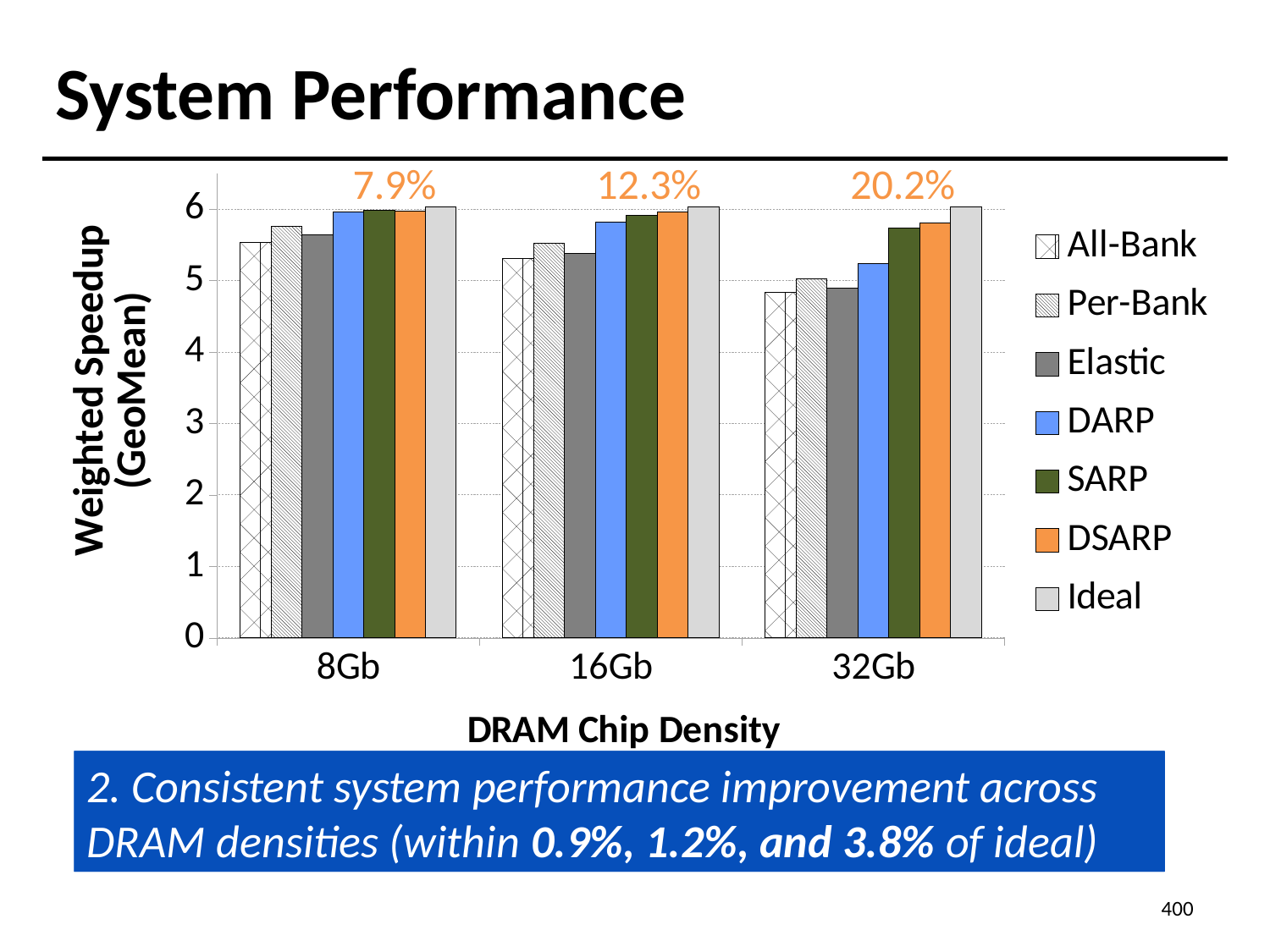
Is the value for DARP at 32Gb greater or less than 5? greater Does the All-Bank weighted speedup rise or fall as DRAM chip density increases from 8Gb to 32Gb? fall What kind of chart is shown on the slide? bar chart What is the title of the x axis? DRAM Chip Density How many DRAM chip density categories are shown on the x axis? 3 How many series does the legend list? 7 Within the 32Gb group, which series has the highest weighted speedup? Ideal At 32Gb, which is larger: Ideal or All-Bank? Ideal Is the value for All-Bank at 8Gb greater or less than 5? greater At 16Gb, which is larger: DARP or Elastic? DARP Is the value for SARP at 32Gb greater or less than 5? greater What percentage is printed above the 16Gb group of bars? 12.3%